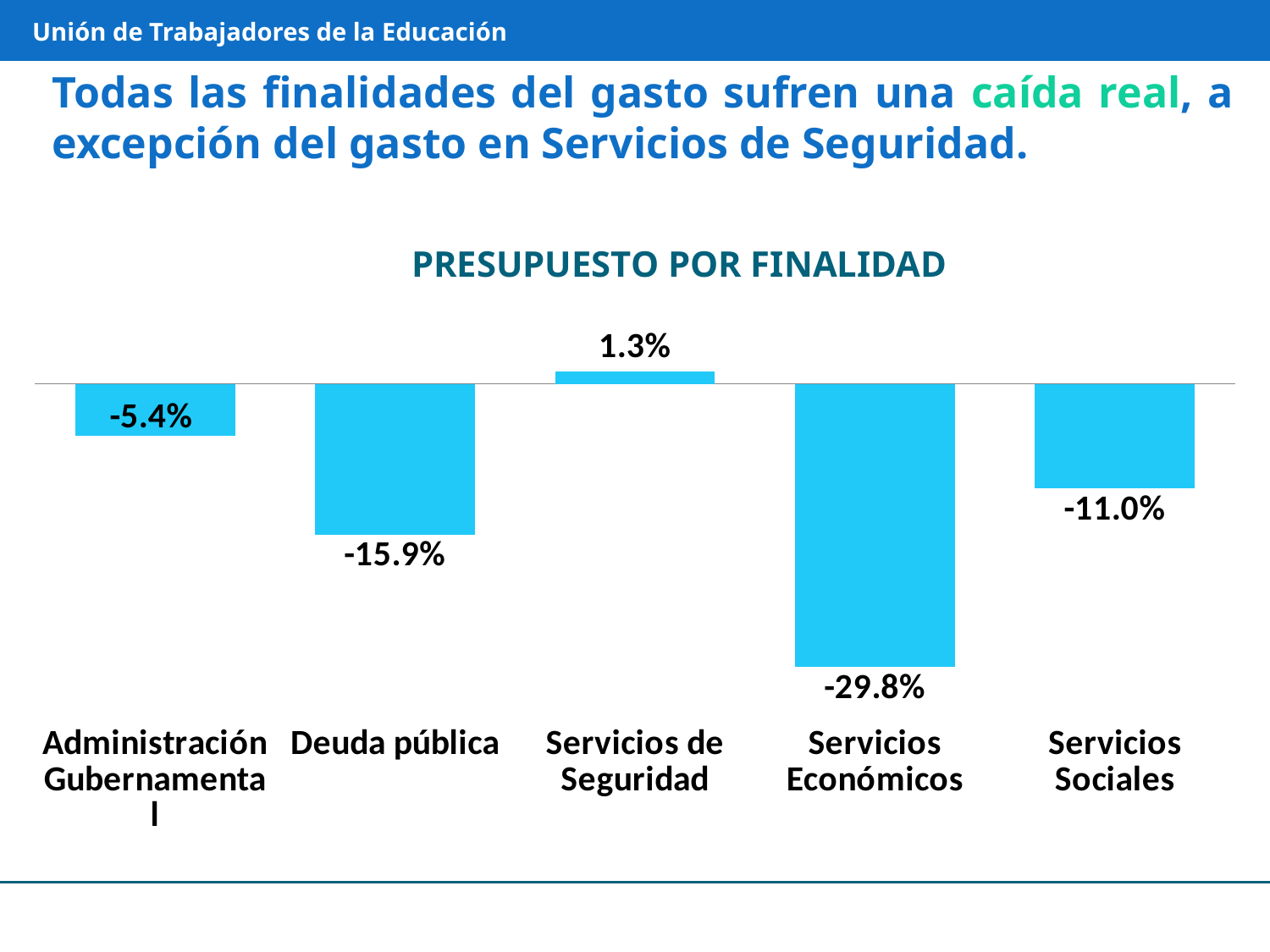
What is the value for Servicios Sociales? -11.0% What is the value for Servicios de Seguridad? 1.3% How many categories are shown in the chart? 5 What is the difference between the values for Servicios Sociales and Servicios Económicos? 18.8 percentage points What is the value for Deuda pública? -15.9% Which category has the lowest value? Servicios Económicos Which is larger, the value for Deuda pública or the value for Servicios Sociales? Servicios Sociales What is the value for Administración Gubernamental? -5.4% What kind of chart is shown on the slide? Bar chart What is the value for Servicios Económicos? -29.8% What is the title of the chart? PRESUPUESTO POR FINALIDAD Which category has the highest value? Servicios de Seguridad